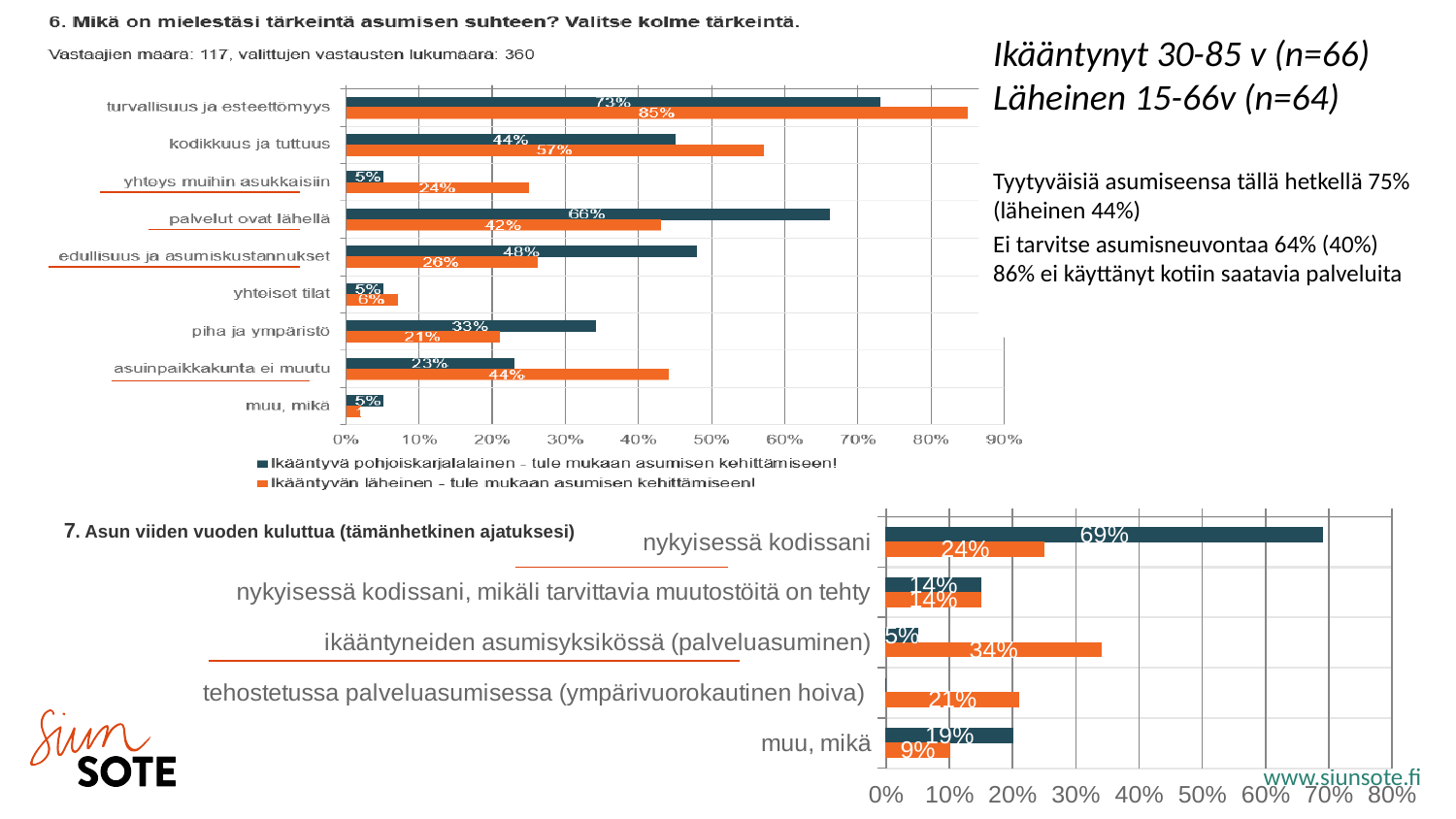
In the top chart (question 6), which category has the highest orange-series value? turvallisuus ja esteettömyys In the bottom chart (question 7), what is the orange value for 'ikääntyneiden asumisyksikössä (palveluasuminen)'? 34% In the top chart (question 6), what is the value of the dark blue series for 'turvallisuus ja esteettömyys'? 73% In the bottom chart (question 7), what is the dark blue value for 'nykyisessä kodissani'? 69% What type of chart is the top chart (question 6)? bar chart In the top chart (question 6), what is the difference between the dark blue and orange values for 'palvelut ovat lähellä'? 24% In the bottom chart (question 7), what is the difference between the dark blue and orange values for 'nykyisessä kodissani'? 45% In the top chart (question 6), which is larger for 'edullisuus ja asumiskustannukset': the dark blue value or the orange value? dark blue (48%) In the top chart (question 6), how many categories are shown on the vertical axis? 9 In the top chart (question 6), what is the value of the orange series for 'asuinpaikkakunta ei muutu'? 44% In the top chart (question 6), how many series does the legend list? 2 In the bottom chart (question 7), how many categories are shown? 5